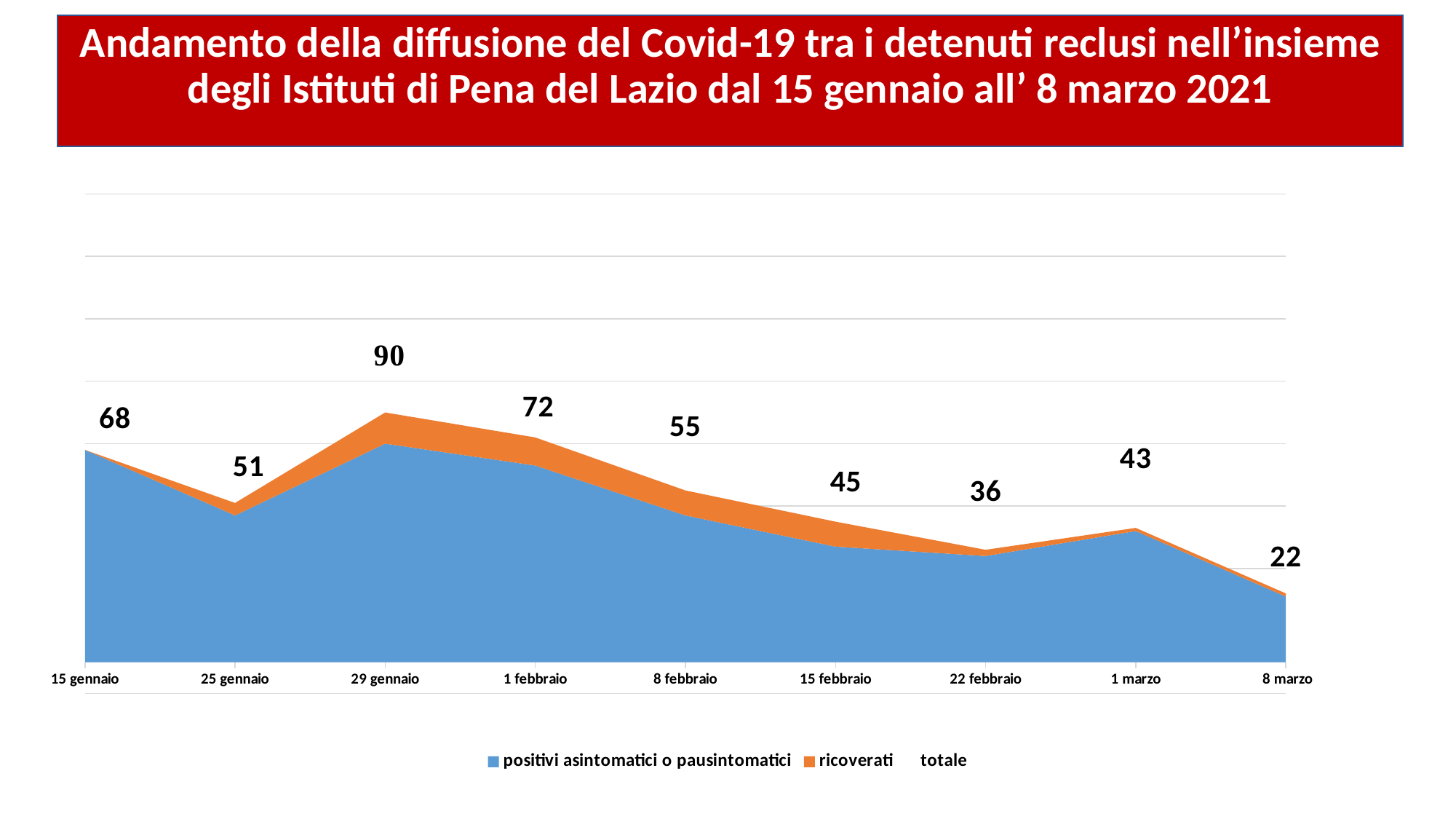
What is the total (totale) value on 15 febbraio? 45 How many series does the legend list? 3 What is the total (totale) value on 29 gennaio? 90 What is the total (totale) value on 8 marzo? 22 What is the difference between the total on 29 gennaio and the total on 15 gennaio? 22 Does the total rise or fall from 29 gennaio to 22 febbraio? Fall On which date is the total (totale) lowest? 8 marzo How many dates are shown on the x axis? 9 What is the difference between the total on 1 febbraio and the total on 8 febbraio? 17 What kind of chart is shown on the slide? Area chart On which date is the total (totale) highest? 29 gennaio Which date has a larger total: 22 febbraio or 1 marzo? 1 marzo